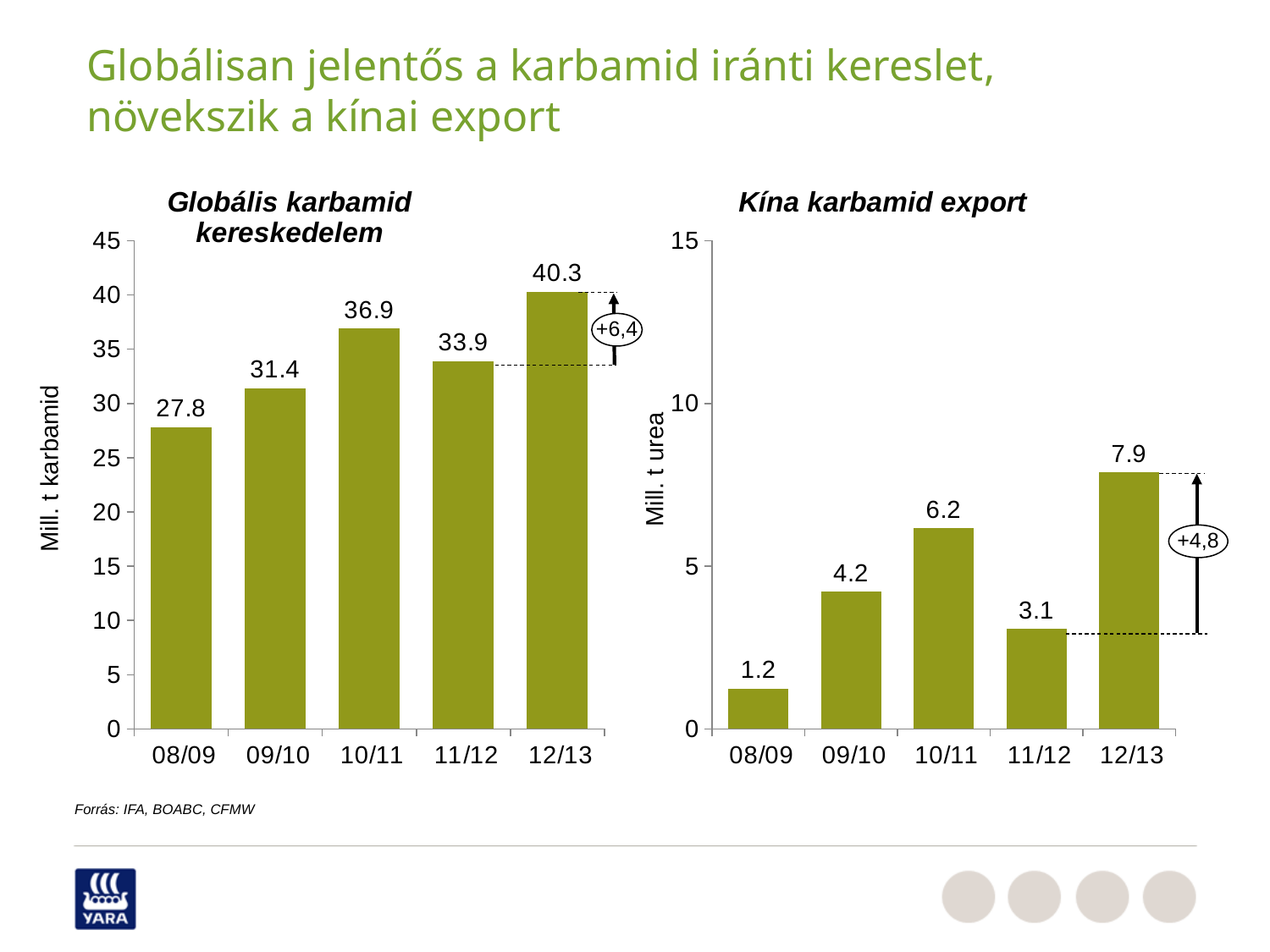
In the 'Globális karbamid kereskedelem' chart, what is the value for 10/11? 36.9 In the 'Kína karbamid export' chart, which year has the lowest value? 08/09 In the 'Globális karbamid kereskedelem' chart, is the value for 09/10 greater or less than 30? greater In the 'Globális karbamid kereskedelem' chart, what is the difference between the 12/13 and 11/12 values? 6.4 In the 'Kína karbamid export' chart, which is larger, the value for 10/11 or the value for 11/12? 10/11 In the 'Kína karbamid export' chart, what is the difference between the 12/13 and 11/12 values? 4.8 In the 'Globális karbamid kereskedelem' chart, what is the y-axis label? Mill. t karbamid In the 'Globális karbamid kereskedelem' chart, which year has the highest value? 12/13 In the 'Kína karbamid export' chart, what is the value for 09/10? 4.2 What kind of chart is the 'Globális karbamid kereskedelem' chart? bar chart In the 'Kína karbamid export' chart, what is the value for 08/09? 1.2 How many years are shown in the 'Kína karbamid export' chart? 5